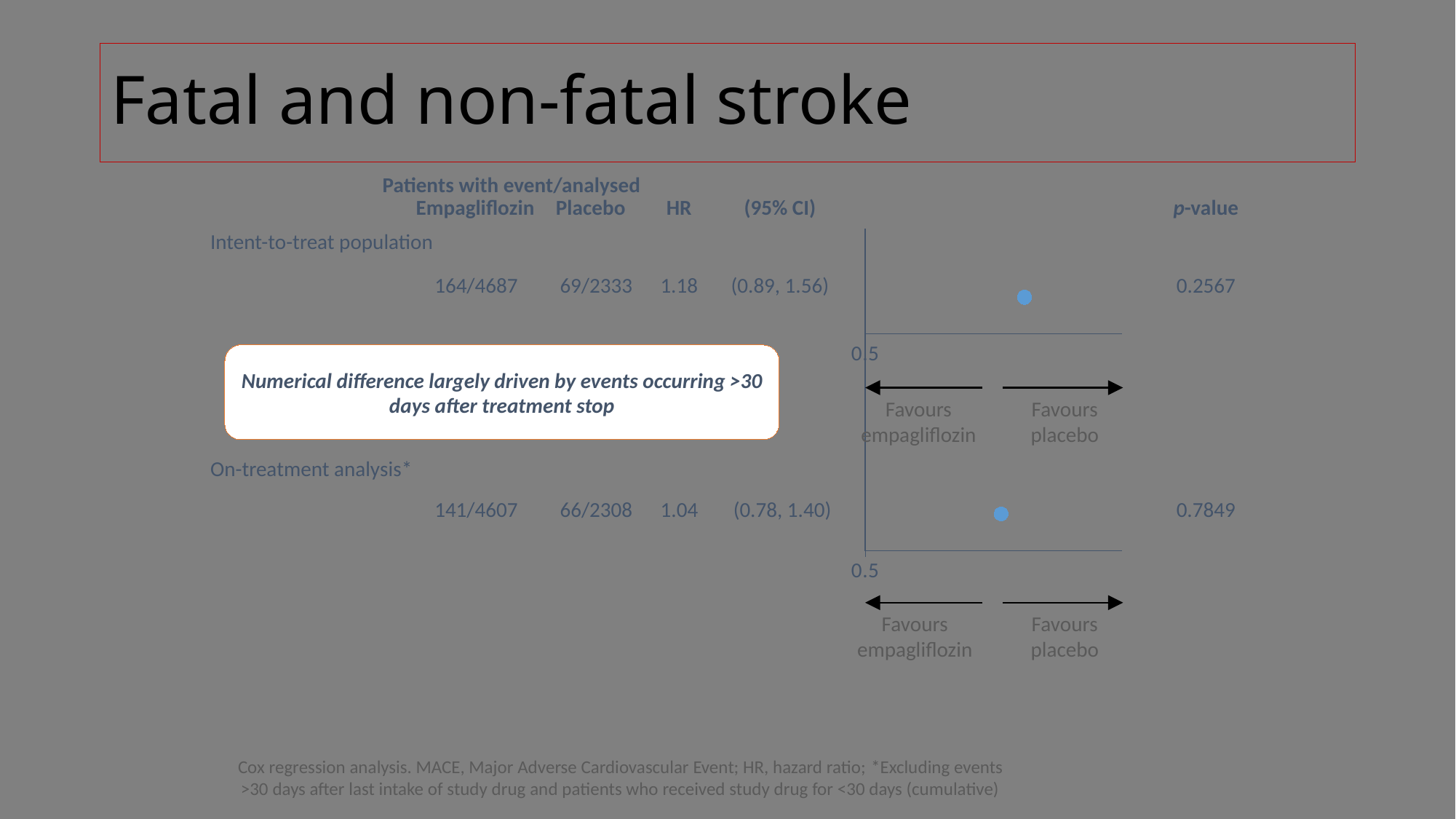
Is the plotted hazard ratio for the on-treatment analysis greater or less than 0.5? greater What is the hazard ratio for the on-treatment analysis? 1.04 What is the p-value for the on-treatment analysis? 0.7849 How many patients with event/analysed are shown for placebo in the on-treatment analysis? 66/2308 What is the 95% CI for the intent-to-treat population hazard ratio? (0.89, 1.56) What is the title of the slide containing the chart? Fatal and non-fatal stroke What is the p-value for the intent-to-treat population? 0.2567 What is the hazard ratio for the intent-to-treat population? 1.18 Which analysis has the higher hazard ratio, intent-to-treat or on-treatment? Intent-to-treat population How many patients with event/analysed are shown for empagliflozin in the intent-to-treat population? 164/4687 What is the difference between the intent-to-treat hazard ratio and the on-treatment hazard ratio? 0.14 What is the 95% CI for the on-treatment analysis hazard ratio? (0.78, 1.40)